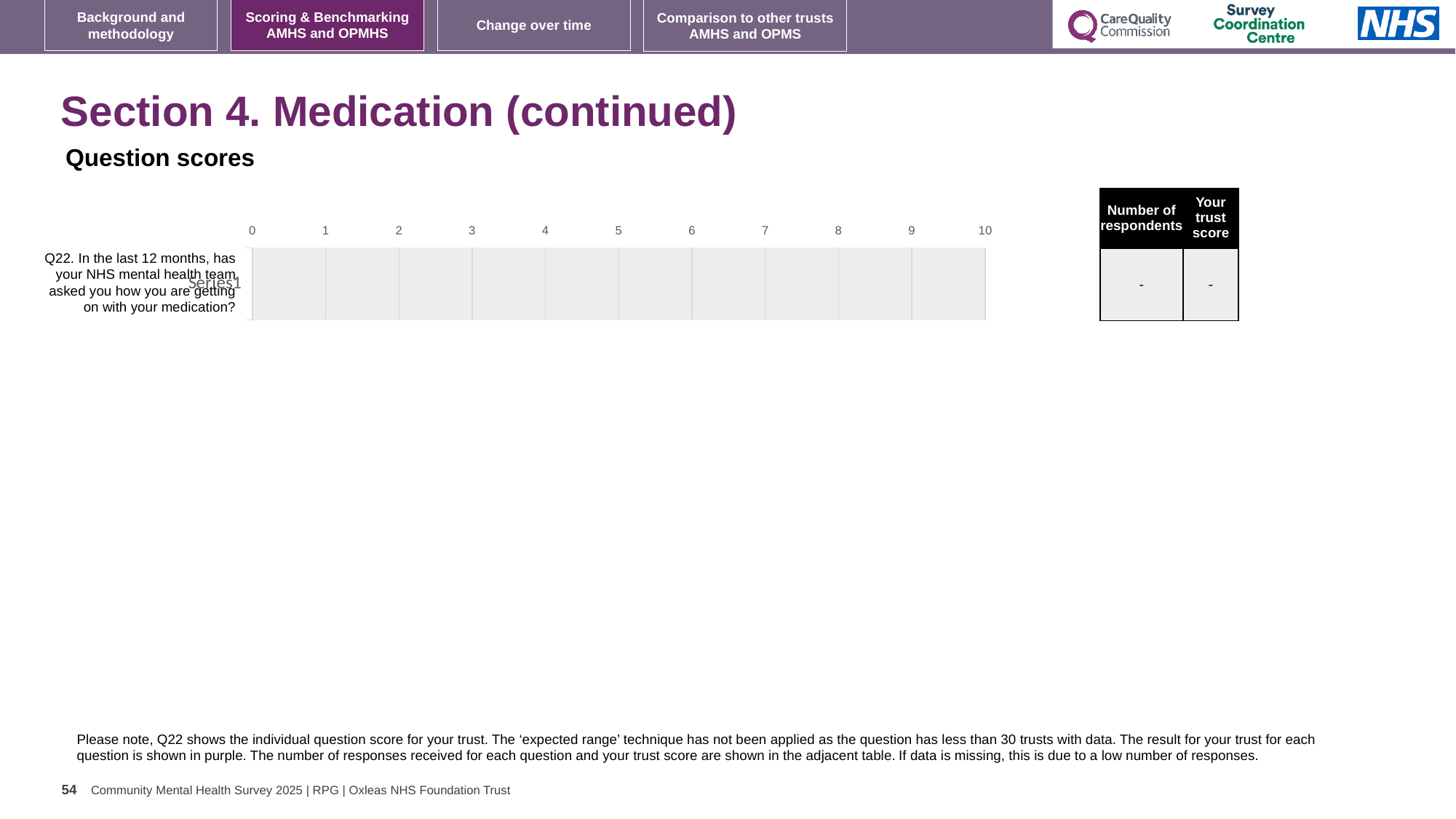
What kind of chart is shown on the slide? Bar chart Which question is listed as the category on the chart? Q22. In the last 12 months, has your NHS mental health team asked you how you are getting on with your medication? What is the highest value shown on the chart's x axis? 10 What is shown in the 'Number of respondents' column of the table for Q22? - What is shown in the 'Your trust score' column of the table for Q22? - Is a bar plotted for Q22 on the chart? No How many question categories are plotted on the chart? 1